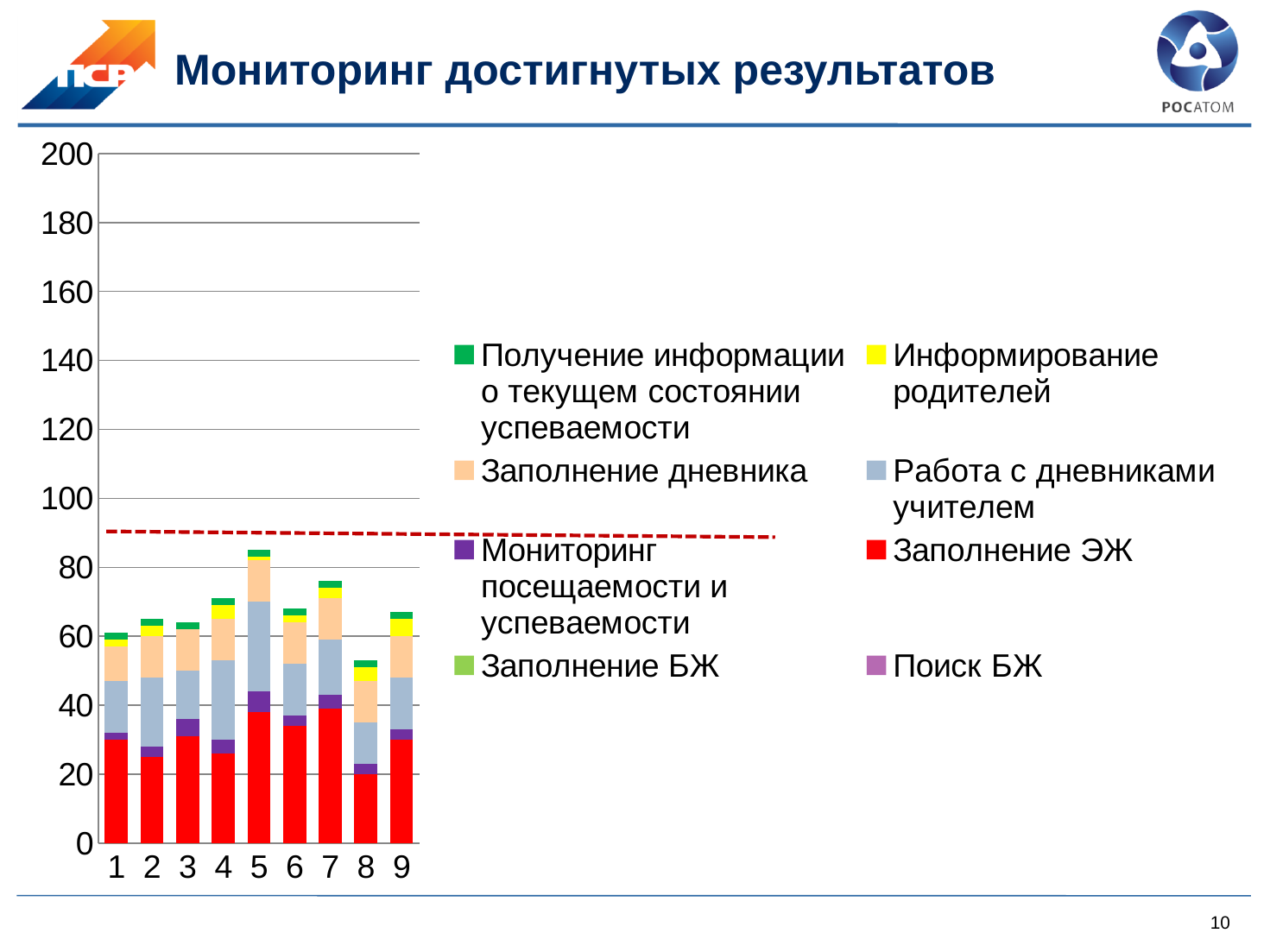
How many series does the chart legend list? 8 How many categories are shown on the x axis of the chart? 9 What is the title of the slide containing the chart? Мониторинг достигнутых результатов Which stacked bar is taller, category 5 or category 8? 5 Which category has the shortest stacked bar? 8 What kind of chart is shown on the slide? Stacked bar chart Which category has the tallest stacked bar? 5 Which colour represents the series "Заполнение ЭЖ" in the chart legend? Red Is the total height of the bar for category 4 greater or less than 60? greater Is the total height of the bar for category 8 greater or less than 60? less Is the total height of the bar for category 7 greater or less than 80? less